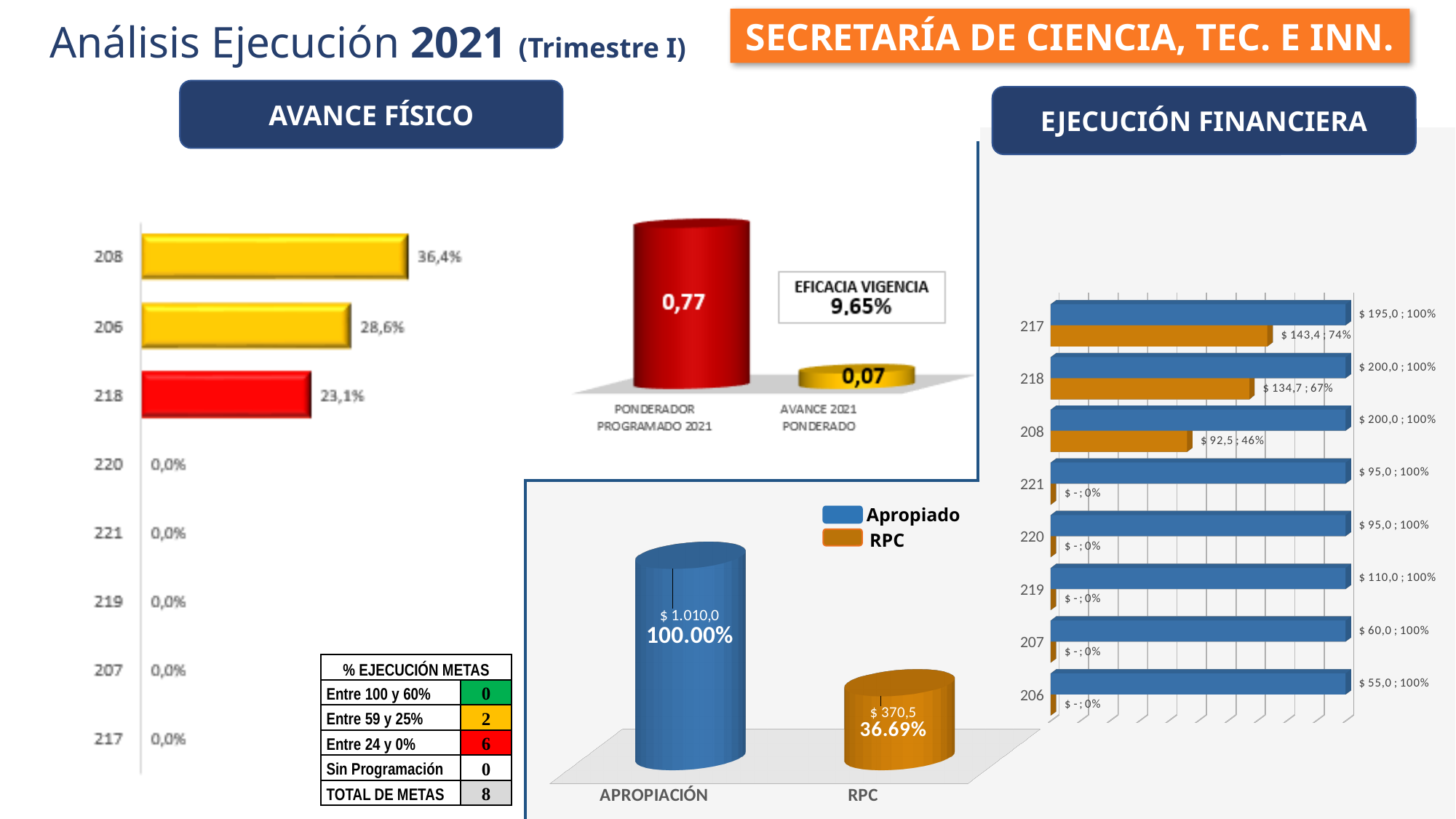
In the Apropiación/RPC chart at the bottom centre, how many series does the legend list? 2 In the chart with Ponderador Programado 2021 and Avance 2021 Ponderado, which of the two values is larger? Ponderador Programado 2021 In the Avance Físico bar chart on the left, how many categories are plotted? 8 In the Avance Físico bar chart on the left, which category has the highest value? 208 In the chart with Ponderador Programado 2021 and Avance 2021 Ponderado, what is the value for Ponderador Programado 2021? 0,77 In the Ejecución Financiera bar chart on the right, what is the difference between the Apropiado values for 218 and 217? $ 5,0 In the Avance Físico bar chart on the left, what is the difference between the values for 208 and 206? 7,8% In the Avance Físico bar chart on the left, what is the value for category 208? 36,4% In the Ejecución Financiera bar chart on the right, which category has the lowest Apropiado value? 206 In the Apropiación/RPC chart at the bottom centre, what percentage is shown for RPC? 36.69% In the Avance Físico bar chart on the left, what kind of chart is it? bar chart In the Ejecución Financiera bar chart on the right, what is the RPC value for category 217? $ 143,4 ; 74%